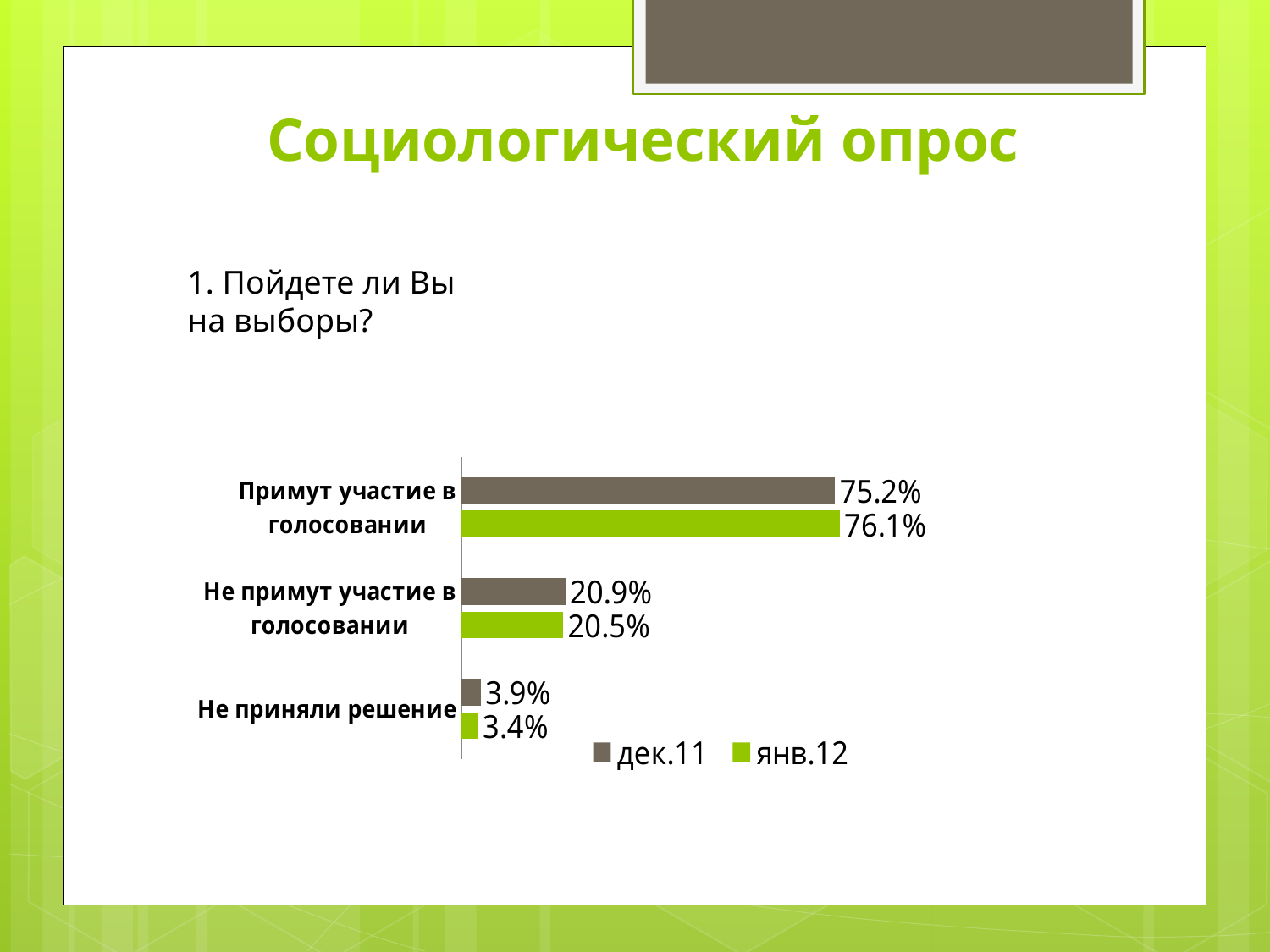
How many categories are shown in the chart? 3 What is the difference between the янв.12 and дек.11 values for "Примут участие в голосовании"? 0.9% What is the value for "Примут участие в голосовании" in the янв.12 series? 76.1% What is the value for "Не приняли решение" in the янв.12 series? 3.4% What is the difference between the дек.11 and янв.12 values for "Не примут участие в голосовании"? 0.4% For "Не приняли решение", which series has the larger value, дек.11 or янв.12? дек.11 What is the value for "Примут участие в голосовании" in the дек.11 series? 75.2% How many series does the legend list? 2 Which category has the highest value in the янв.12 series? Примут участие в голосовании What is the value for "Не примут участие в голосовании" in the дек.11 series? 20.9% Which category has the lowest value in the дек.11 series? Не приняли решение What kind of chart is shown on the slide? Bar chart